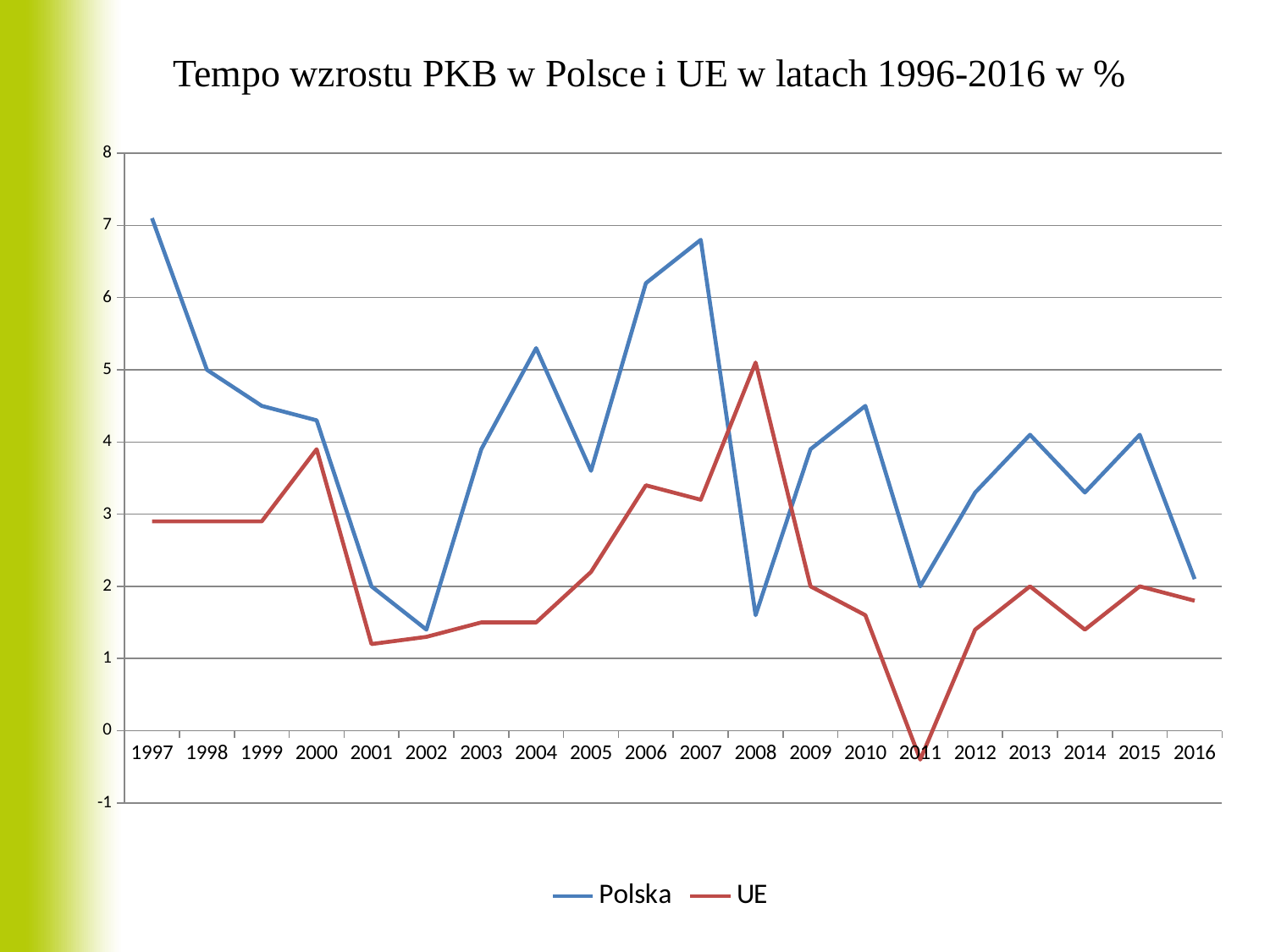
Which series has the larger value in 2007, Polska or UE? Polska In which year does the UE series reach its lowest value? 2011 Is the value for UE in 2011 greater or less than 0? less Is the value for Polska in 2007 greater or less than 6? greater How many years are plotted along the x axis? 20 How many series does the legend list? 2 In which year does the Polska series reach its highest value? 1997 Does the Polska series rise or fall from 1997 to 2001? fall Which series has the larger value in 2008, Polska or UE? UE Is the value for Polska in 2008 greater or less than 2? less What kind of chart is shown on the slide? line chart In which year does the UE series reach its highest value? 2008